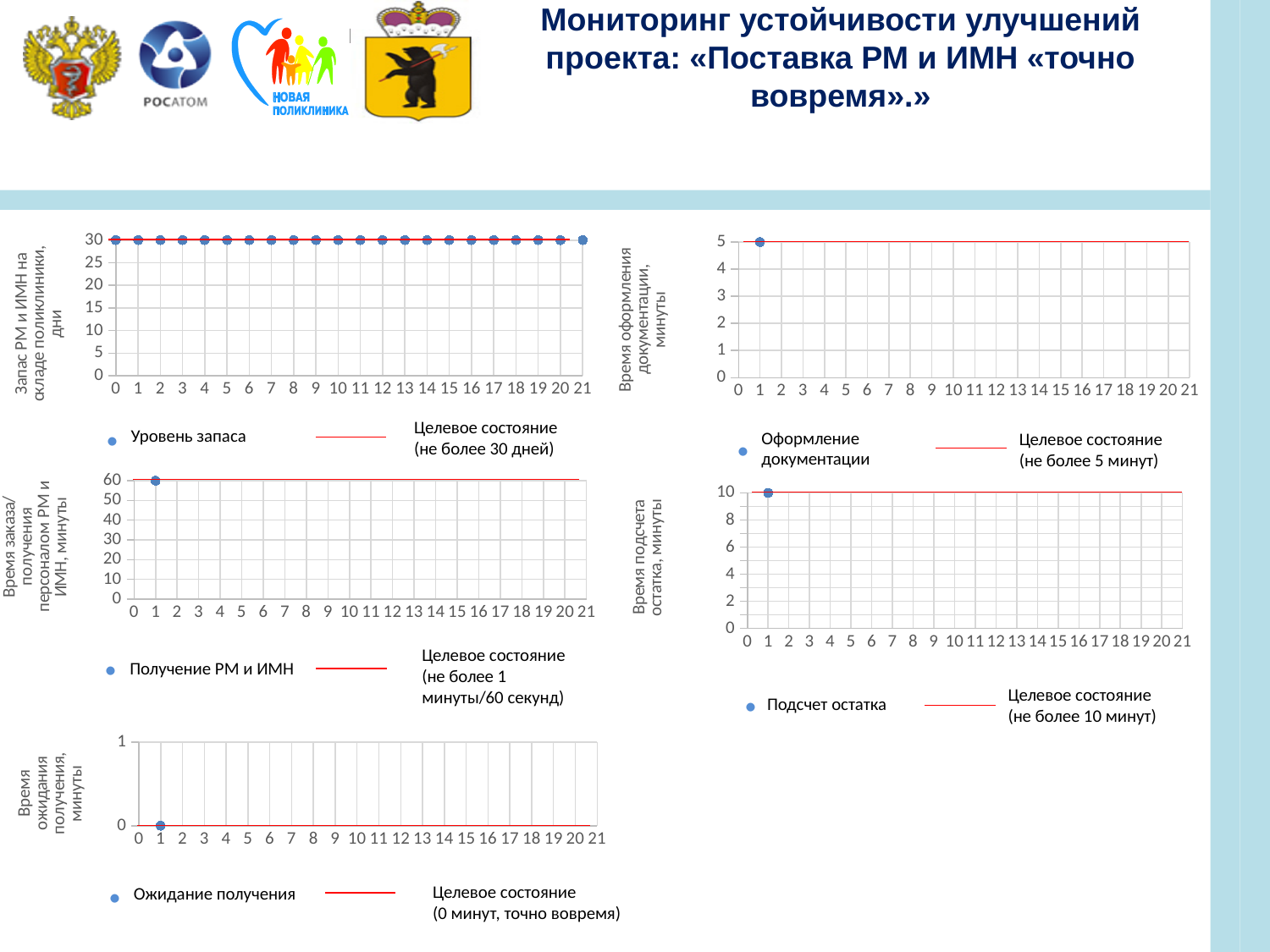
On the top-left chart (Запас РМ и ИМН на складе поликлиники, дни), what value does the Уровень запаса series show at x = 0? 30 On the top-right chart (Время оформления документации, минуты), how many series does the legend list? 2 Which is larger: the Подсчет остатка value at x = 1 on the middle-right chart or the Оформление документации value at x = 1 on the top-right chart? Подсчет остатка On the middle-left chart (Время заказа/получения персоналом РМ и ИМН, минуты), what value does the Получение РМ и ИМН point show at x = 1? 60 On the top-left chart (Запас РМ и ИМН на складе поликлиники, дни), what is the target state given in the legend? Целевое состояние (не более 30 дней) On the middle-right chart (Время подсчета остатка, минуты), what value does the Подсчет остатка point show at x = 1? 10 On the middle-left chart (Время заказа/получения персоналом РМ и ИМН, минуты), how many data points are plotted for Получение РМ и ИМН? 1 On the bottom-left chart (Время ожидания получения, минуты), what is the highest value shown on the y axis? 1 On the bottom-left chart (Время ожидания получения, минуты), what value does the Ожидание получения point show at x = 1? 0 On the top-left chart (Запас РМ и ИМН на складе поликлиники, дни), do the Уровень запаса values rise, fall or stay constant along the x axis? stay constant On the top-right chart (Время оформления документации, минуты), what value does the Оформление документации point show at x = 1? 5 On the top-left chart (Запас РМ и ИМН на складе поликлиники, дни), how many series does the legend list? 2